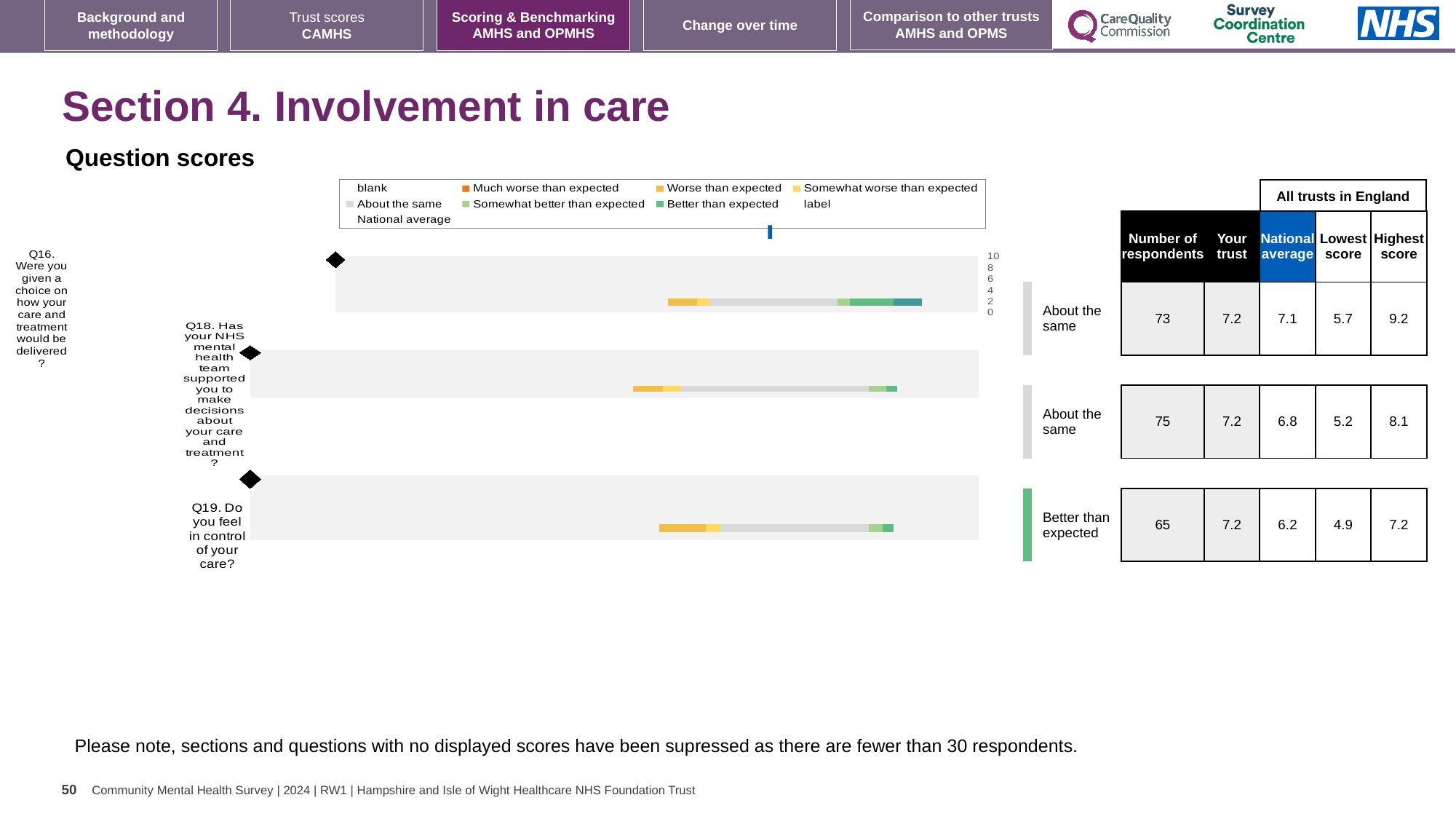
How many respondents are listed for Q16 'Were you given a choice on how your care and treatment would be delivered?'? 73 What is the national average score for Q18 'Has your NHS mental health team supported you to make decisions about your care and treatment?'? 6.8 Which question has the highest national average score? Q16 What is the 'Your trust' score for Q18? 7.2 How many questions are plotted in the question scores chart? 3 What is the difference between the highest score and the lowest score for Q16? 3.5 Which question has the lowest 'Lowest score' value? Q19 What is the highest score among all trusts in England for Q19 'Do you feel in control of your care?'? 7.2 Which has the higher national average, Q16 or Q19? Q16 What kind of chart is used to show the question scores on this slide? bar chart In the chart legend, what colour represents 'Much worse than expected'? orange What benchmark label is shown next to the bar for Q19 'Do you feel in control of your care?'? Better than expected